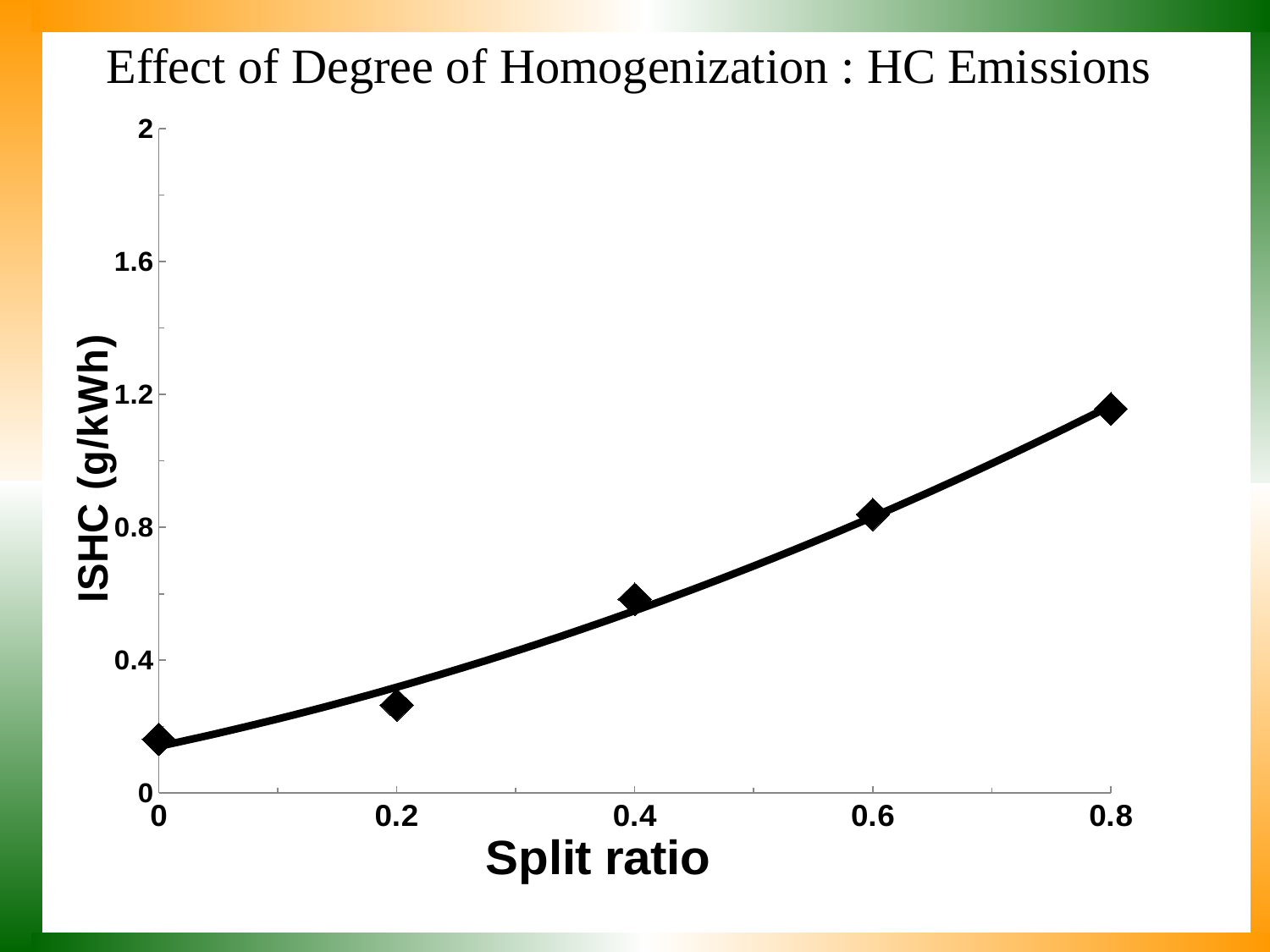
Is the ISHC value at split ratio 0.8 greater or less than 0.8? greater Does ISHC rise or fall as the split ratio increases? rise What kind of chart is shown on the slide? scatter chart What is the label of the x axis? Split ratio What is the title of the chart? Effect of Degree of Homogenization : HC Emissions Which has the larger ISHC value: split ratio 0.2 or split ratio 0.6? 0.6 Is the ISHC value at split ratio 0.6 greater or less than 1.2? less Is the ISHC value at split ratio 0.2 greater or less than 0.4? less At which split ratio is ISHC lowest? 0 At which split ratio is ISHC highest? 0.8 How many data points are plotted on the chart? 5